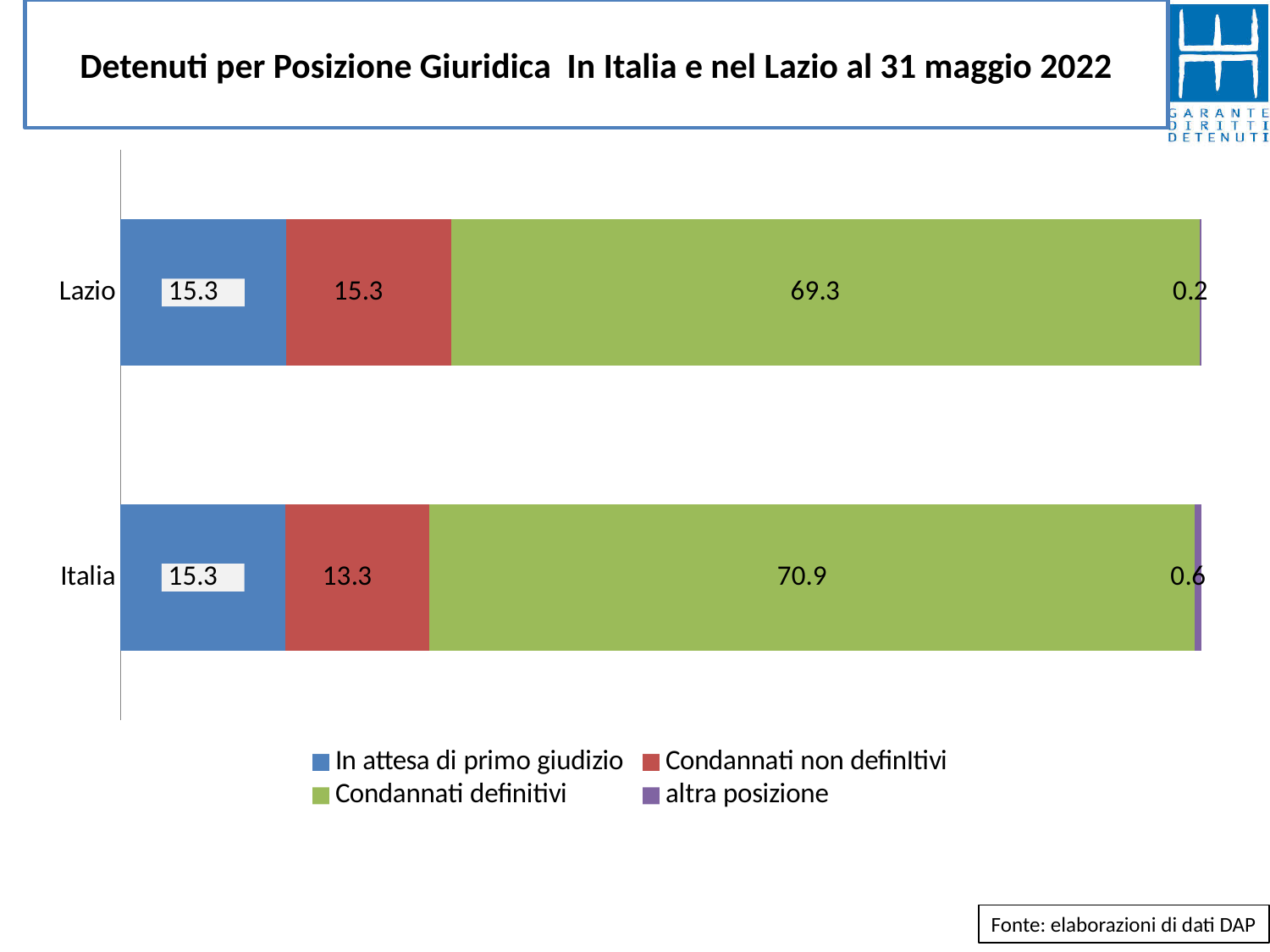
Which is larger, Condannati non definitivi in Lazio or in Italia? Lazio What is the value for Condannati non definitivi in Italia? 13.3 What is the value for altra posizione in Italia? 0.6 What is the value for altra posizione in Lazio? 0.2 Which series has the highest value for Italia? Condannati definitivi How many categories are shown on the chart? 2 What is the value for Condannati definitivi in Lazio? 69.3 How many series does the legend list? 4 What is the value for In attesa di primo giudizio in Lazio? 15.3 Which series has the lowest value for Lazio? altra posizione What kind of chart is shown on the slide? Stacked bar chart What is the difference between the Condannati definitivi values for Italia and Lazio? 1.6